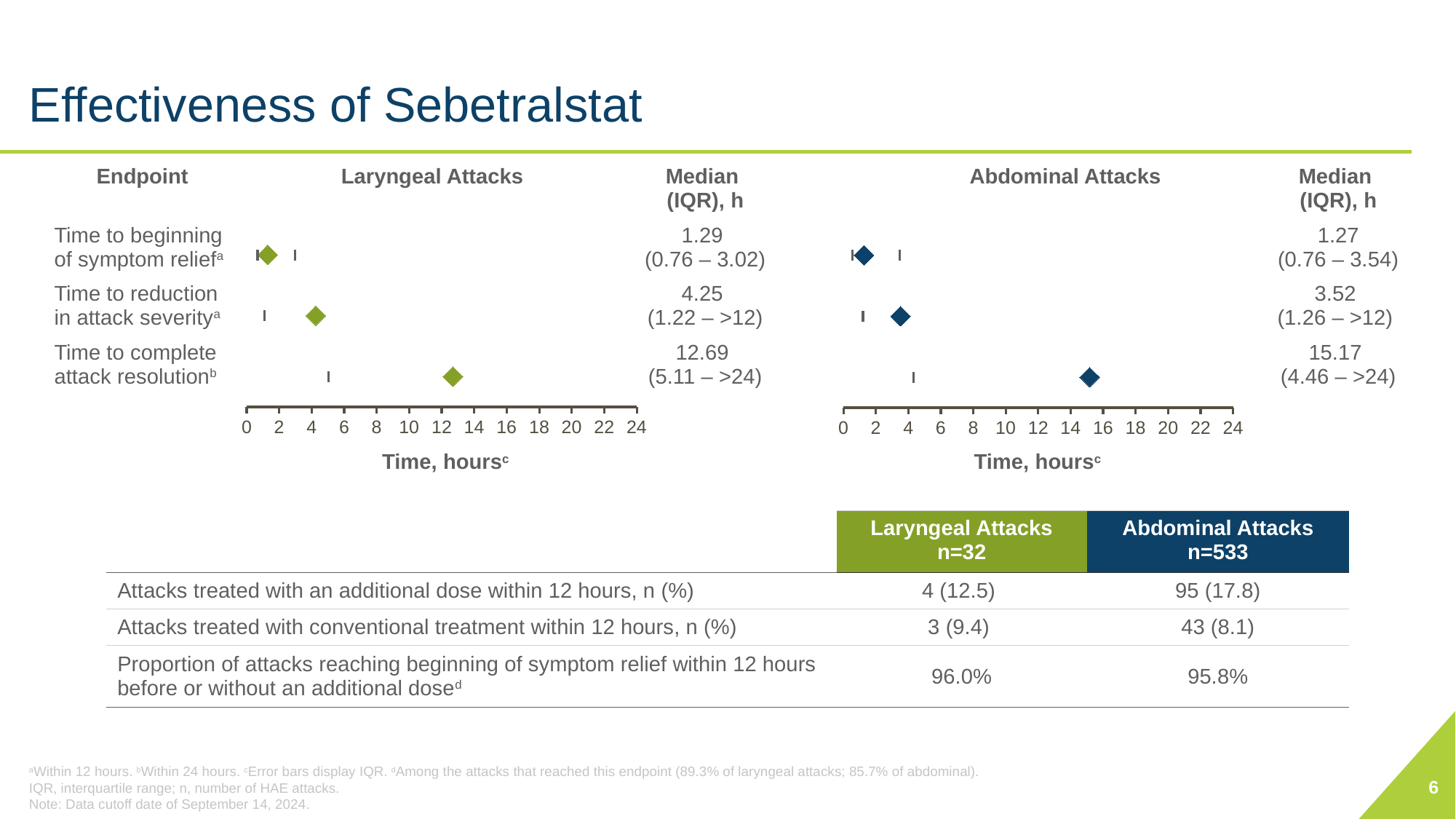
How many endpoints are plotted in the Laryngeal Attacks chart? 3 In the Laryngeal Attacks chart, which endpoint has the highest median time? Time to complete attack resolution In the Abdominal Attacks chart, what is the median time to complete attack resolution in hours? 15.17 In the Abdominal Attacks chart, is the median time to complete attack resolution greater or less than 14 hours? greater In the Laryngeal Attacks chart, is the median time to reduction in attack severity greater or less than 6 hours? less In the Laryngeal Attacks chart, what is the median time to beginning of symptom relief in hours? 1.29 In the Laryngeal Attacks chart, what is the difference in hours between the median time to complete attack resolution and the median time to reduction in attack severity? 8.44 What kind of chart is used to show the Laryngeal Attacks and Abdominal Attacks data? Dot plot with error bars In the Abdominal Attacks chart, which endpoint has the lowest median time? Time to beginning of symptom relief In the Abdominal Attacks chart, what is the median time to reduction in attack severity in hours? 3.52 What is the x-axis label of the Abdominal Attacks chart? Time, hours For time to complete attack resolution, which chart shows the larger median: Laryngeal Attacks or Abdominal Attacks? Abdominal Attacks